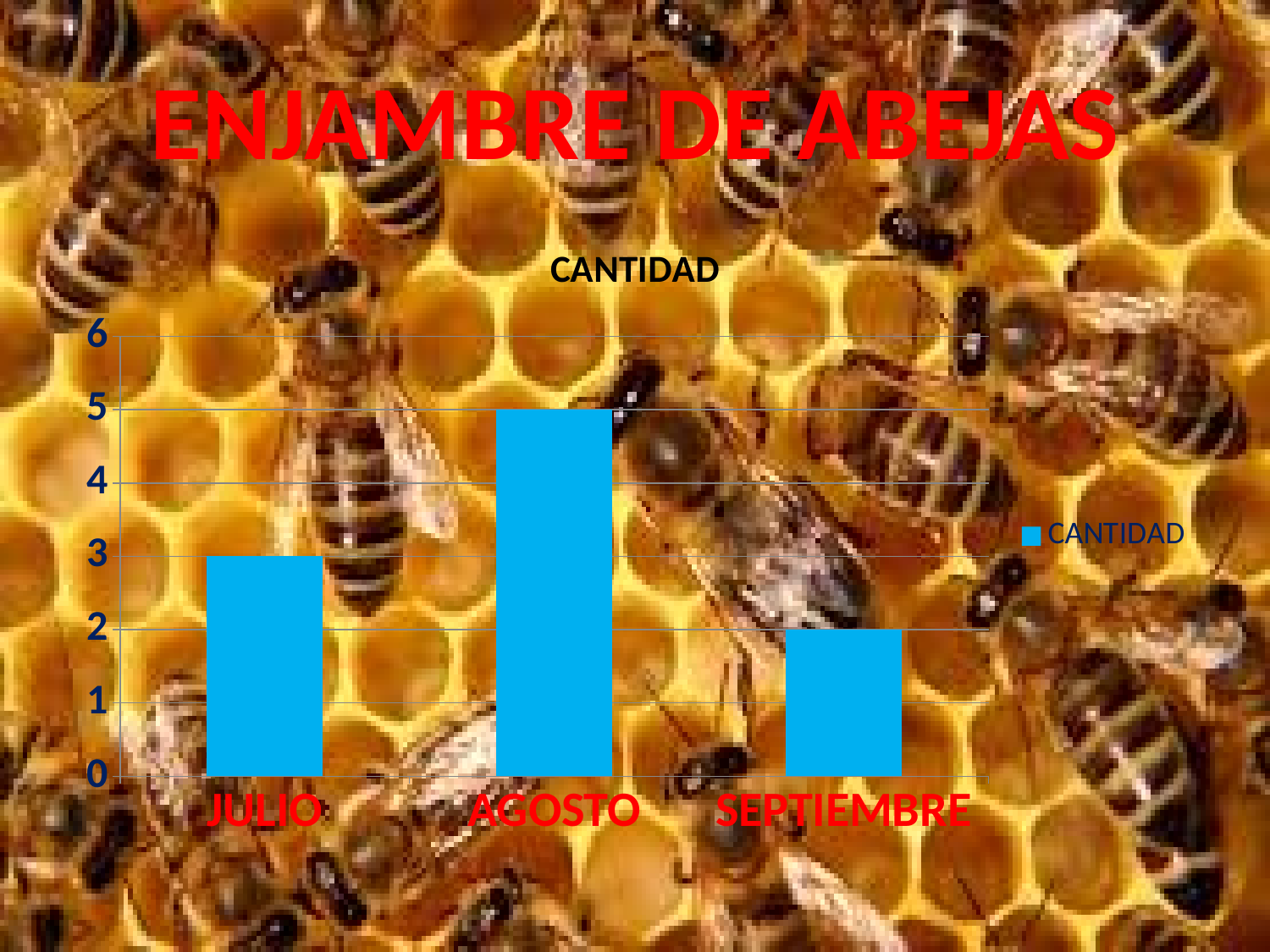
What is the value for JULIO in the CANTIDAD chart? 3 Is the value for AGOSTO greater or less than 4? greater What kind of chart is shown on the slide? bar chart Which month has the highest value in the CANTIDAD chart? AGOSTO How many months are shown on the x axis of the chart? 3 How many series does the legend list? 1 What is the value for AGOSTO in the CANTIDAD chart? 5 Which month has the lowest value in the CANTIDAD chart? SEPTIEMBRE What is the value for SEPTIEMBRE in the CANTIDAD chart? 2 Which is larger, the value for JULIO or the value for SEPTIEMBRE? JULIO What is the difference between the values for AGOSTO and SEPTIEMBRE? 3 What is the title of the chart? CANTIDAD